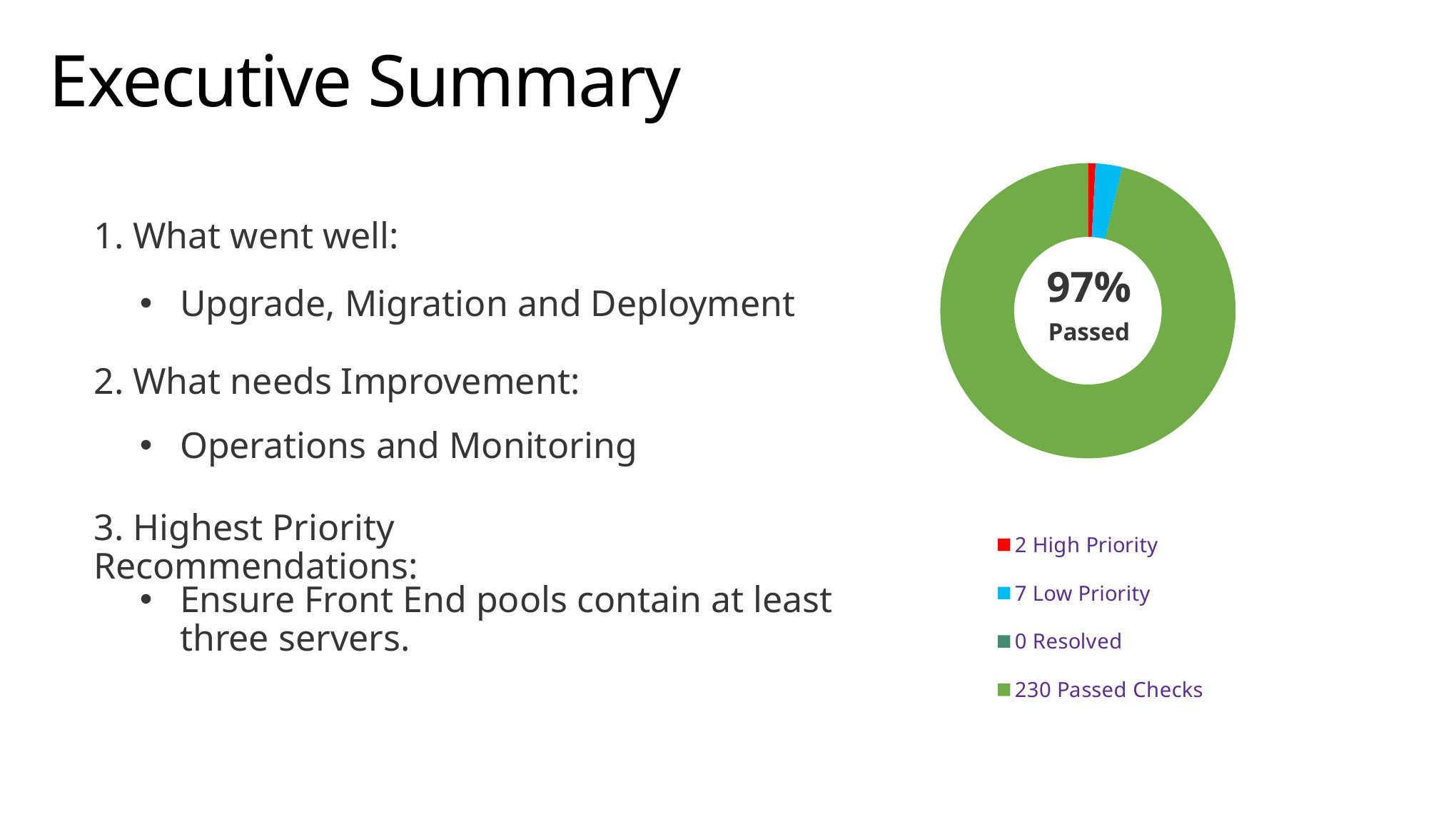
How many Low Priority items does the chart legend show? 7 What is the difference between the number of Low Priority and High Priority items? 5 Which is larger, the number of High Priority items or the number of Low Priority items? Low Priority What colour represents Passed Checks in the chart? green How many categories are listed in the chart legend? 4 How many Passed Checks does the chart legend show? 230 Which category has the largest value in the chart? Passed Checks How many High Priority items does the chart legend show? 2 How many Resolved items does the chart legend show? 0 What percentage is displayed in the centre of the donut chart? 97% Which category has the smallest value in the chart? Resolved What kind of chart is shown on the slide? donut chart